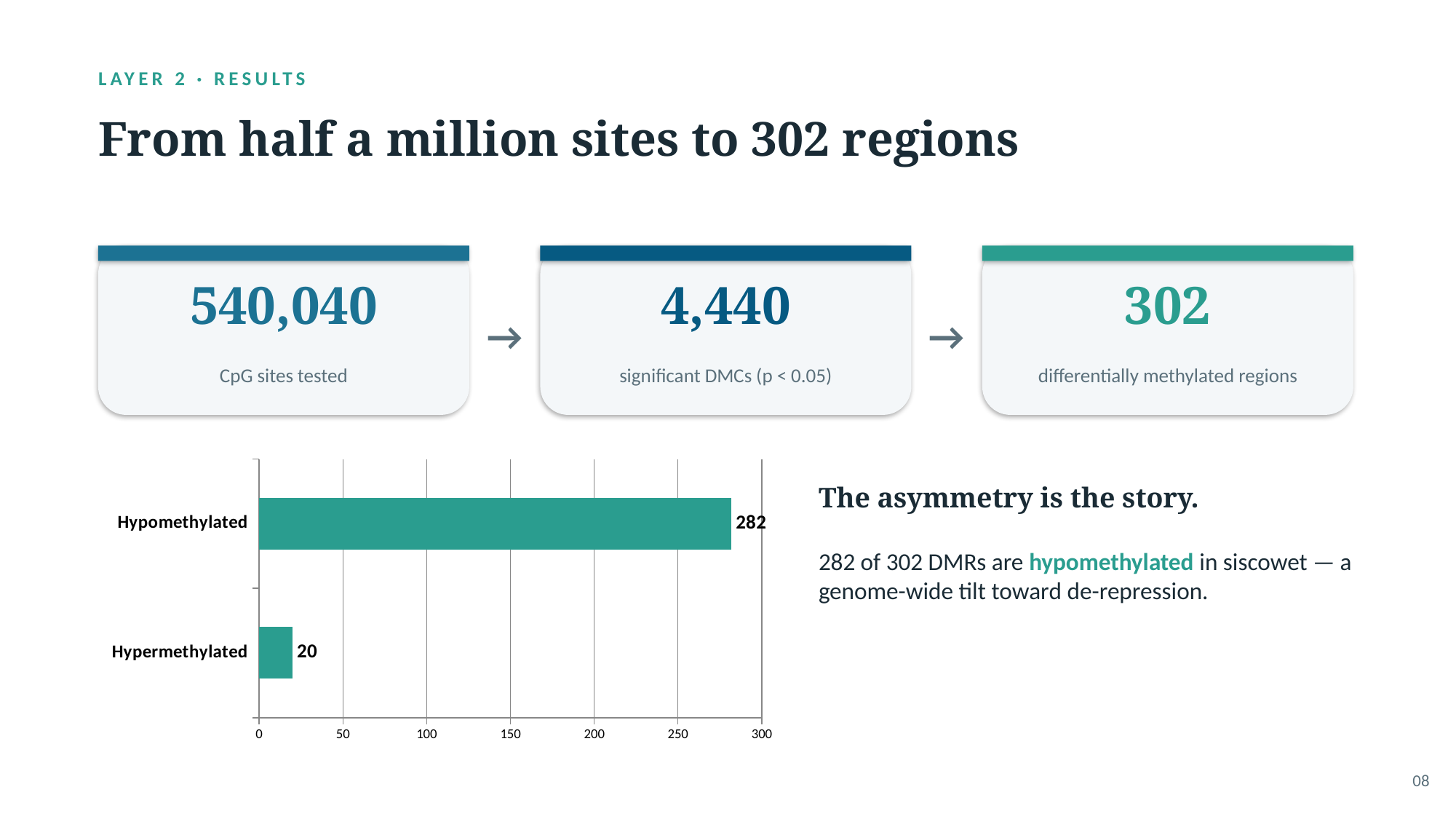
What is the value for Hypermethylated? 20 What is the maximum value shown on the chart's x axis? 300 Which is larger, the value for Hypomethylated or the value for Hypermethylated? Hypomethylated Is the value for Hypermethylated greater or less than 50? less How many categories are shown in the chart? 2 Which category has the lowest value? Hypermethylated What is the value for Hypomethylated? 282 What is the total of the two bars in the chart? 302 What kind of chart is shown on the slide? bar chart Which category has the highest value? Hypomethylated Is the value for Hypomethylated greater or less than 250? greater What is the difference between the Hypomethylated and Hypermethylated values? 262